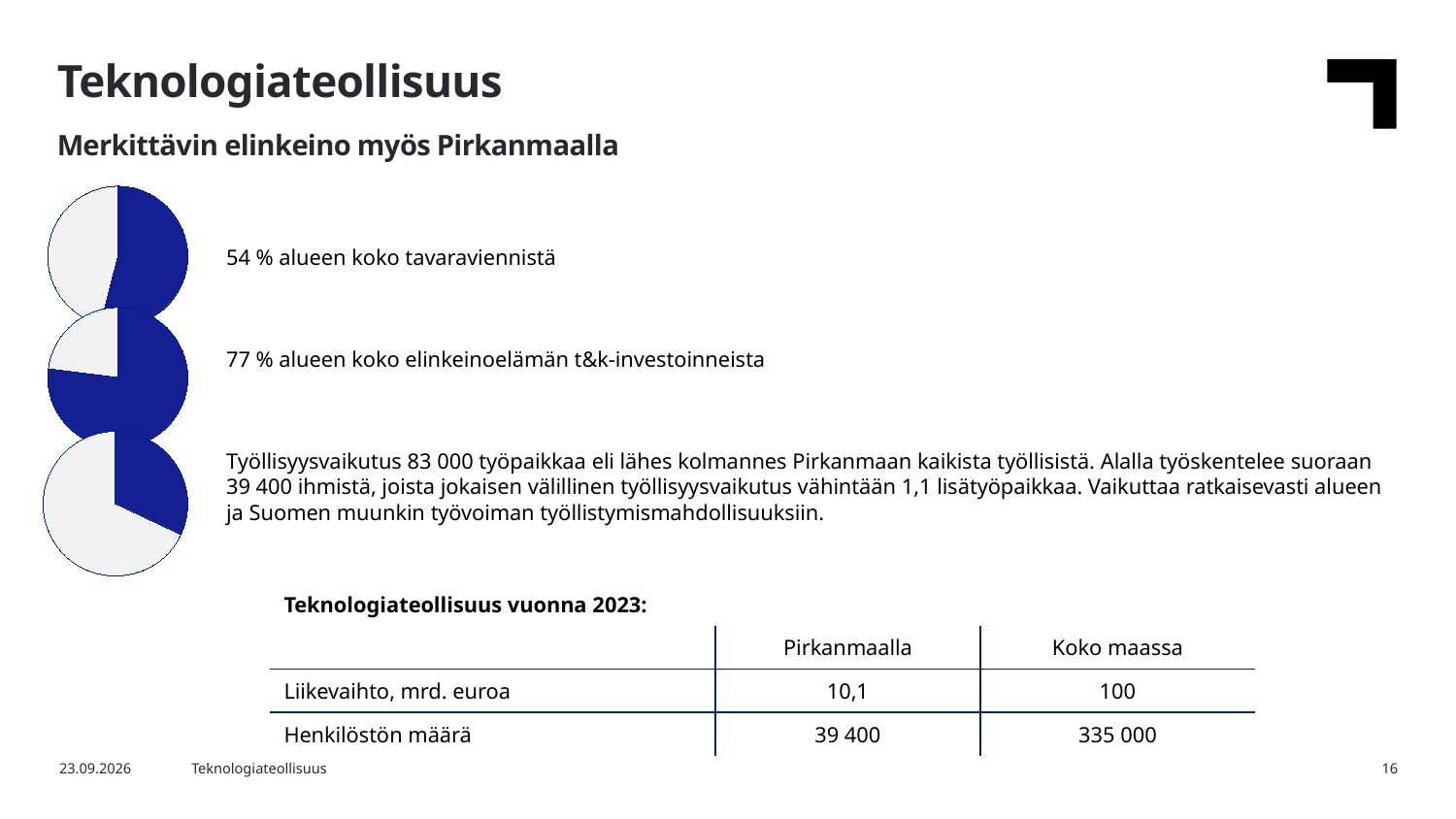
Which of the three pie charts has the largest blue slice? The middle pie chart (77 %) What is the difference in percentage points between the blue shares of the middle pie chart and the top pie chart? 23 percentage points In the top pie chart, what share of the region's total goods exports does the blue slice represent? 54 % Is the blue slice in the bottom pie chart larger or smaller than half of the pie? Smaller How many pie charts are on the slide? 3 What does the top pie chart illustrate, according to the text next to it? 54 % alueen koko tavaraviennistä Which of the three pie charts has the smallest blue slice? The bottom pie chart What colour is used for the highlighted slice in each pie chart? Blue Is the blue slice larger in the top pie chart or in the middle pie chart? The middle pie chart What kind of charts are shown on the left side of the slide? Pie charts In the middle pie chart, what share of the region's business R&D investments does the blue slice represent? 77 %